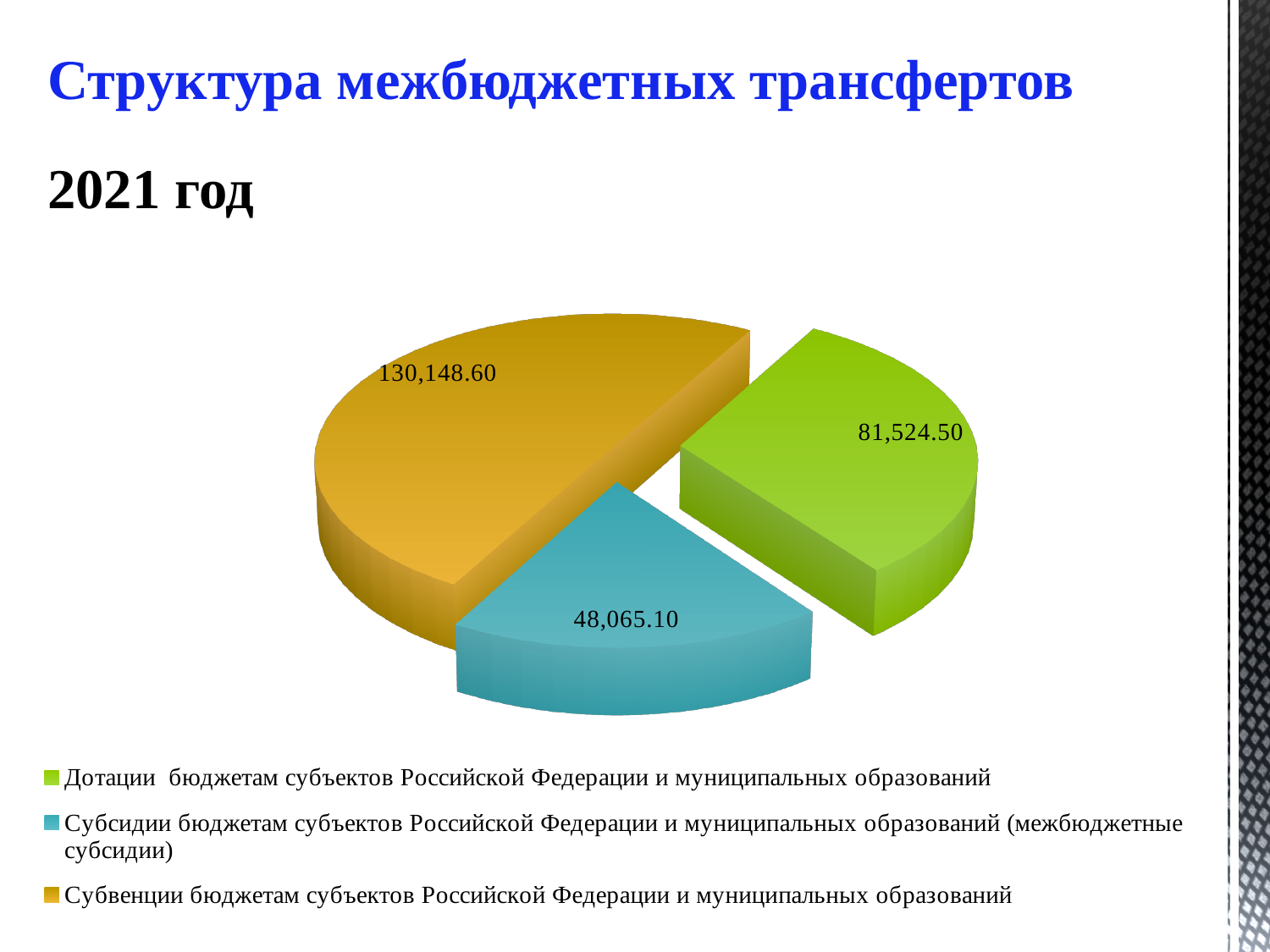
What kind of chart is shown on the slide? Pie chart What is the difference between the value for Субвенции and the value for Дотации? 48,624.10 What is the value for Дотации бюджетам субъектов Российской Федерации и муниципальных образований? 81,524.50 What is the value for Субвенции бюджетам субъектов Российской Федерации и муниципальных образований? 130,148.60 Which category has the largest slice of the pie? Субвенции бюджетам субъектов Российской Федерации и муниципальных образований How many slices does the pie chart have? 3 What colour is the slice for Субвенции бюджетам субъектов Российской Федерации и муниципальных образований? Orange (gold) What is the value for Субсидии бюджетам субъектов Российской Федерации и муниципальных образований (межбюджетные субсидии)? 48,065.10 Which is larger, the value for Дотации or the value for Субсидии? Дотации What is the total of all three slices of the pie? 259,738.20 What is the difference between the value for Дотации and the value for Субсидии? 33,459.40 Which category has the smallest slice of the pie? Субсидии бюджетам субъектов Российской Федерации и муниципальных образований (межбюджетные субсидии)